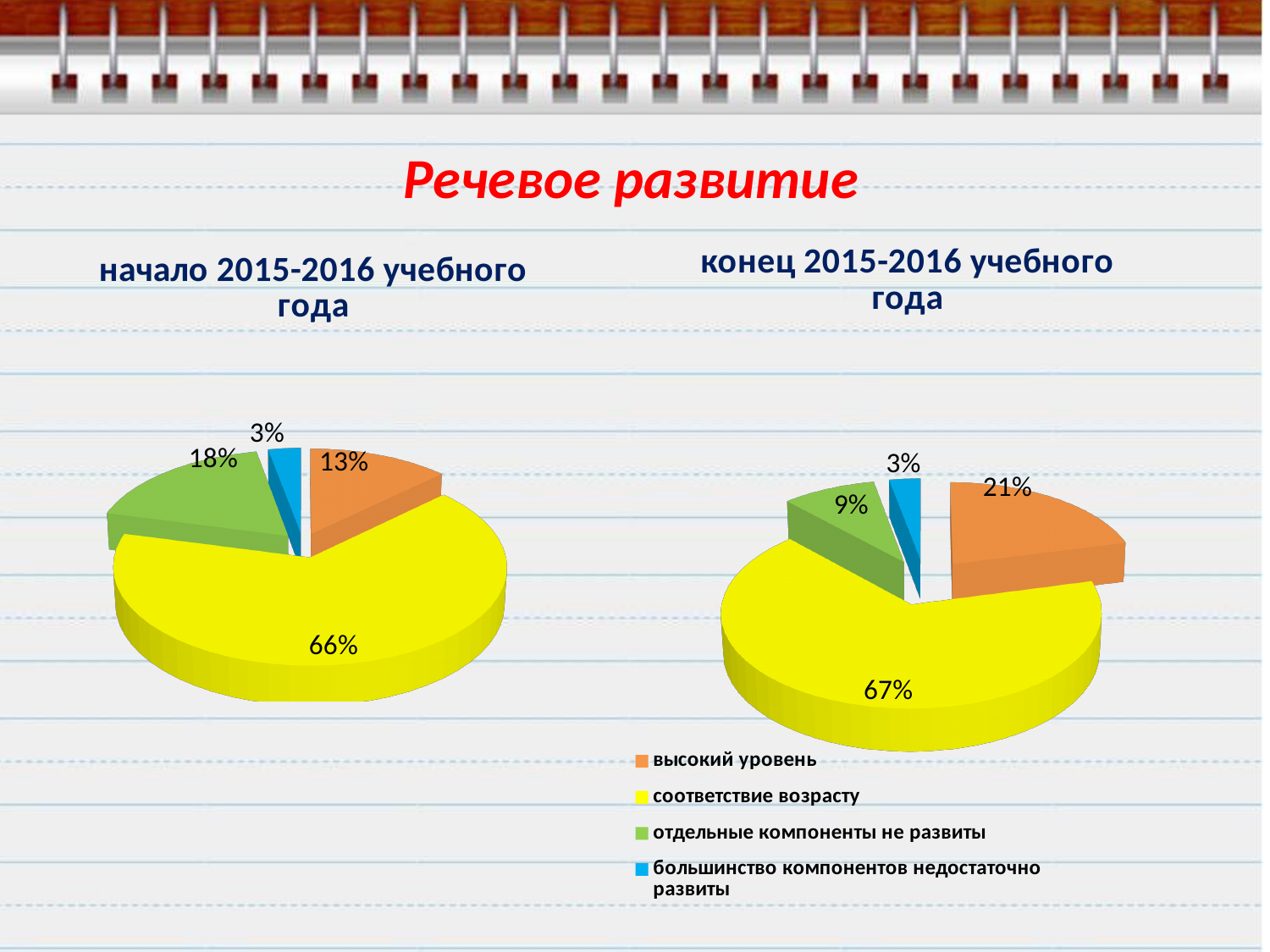
How many entries does the legend on the slide list? 4 In the chart titled «конец 2015-2016 учебного года», what share is labelled for «высокий уровень»? 21% In the chart titled «конец 2015-2016 учебного года», which category has the smallest slice? большинство компонентов недостаточно развиты In the chart titled «начало 2015-2016 учебного года», what share is labelled for «соответствие возрасту»? 66% In the chart titled «начало 2015-2016 учебного года», which category has the largest slice? соответствие возрасту By how many percentage points did the «высокий уровень» share change from the «начало 2015-2016 учебного года» chart to the «конец 2015-2016 учебного года» chart? 8 percentage points What colour represents «соответствие возрасту» in the legend? Yellow Which is larger: the «отдельные компоненты не развиты» share in the «начало 2015-2016 учебного года» chart or in the «конец 2015-2016 учебного года» chart? начало 2015-2016 учебного года In the chart titled «конец 2015-2016 учебного года», what share is labelled for «отдельные компоненты не развиты»? 9% What type of chart is the chart titled «конец 2015-2016 учебного года»? Pie chart How many slices does the chart titled «начало 2015-2016 учебного года» have? 4 In the chart titled «начало 2015-2016 учебного года», what share is labelled for «отдельные компоненты не развиты»? 18%